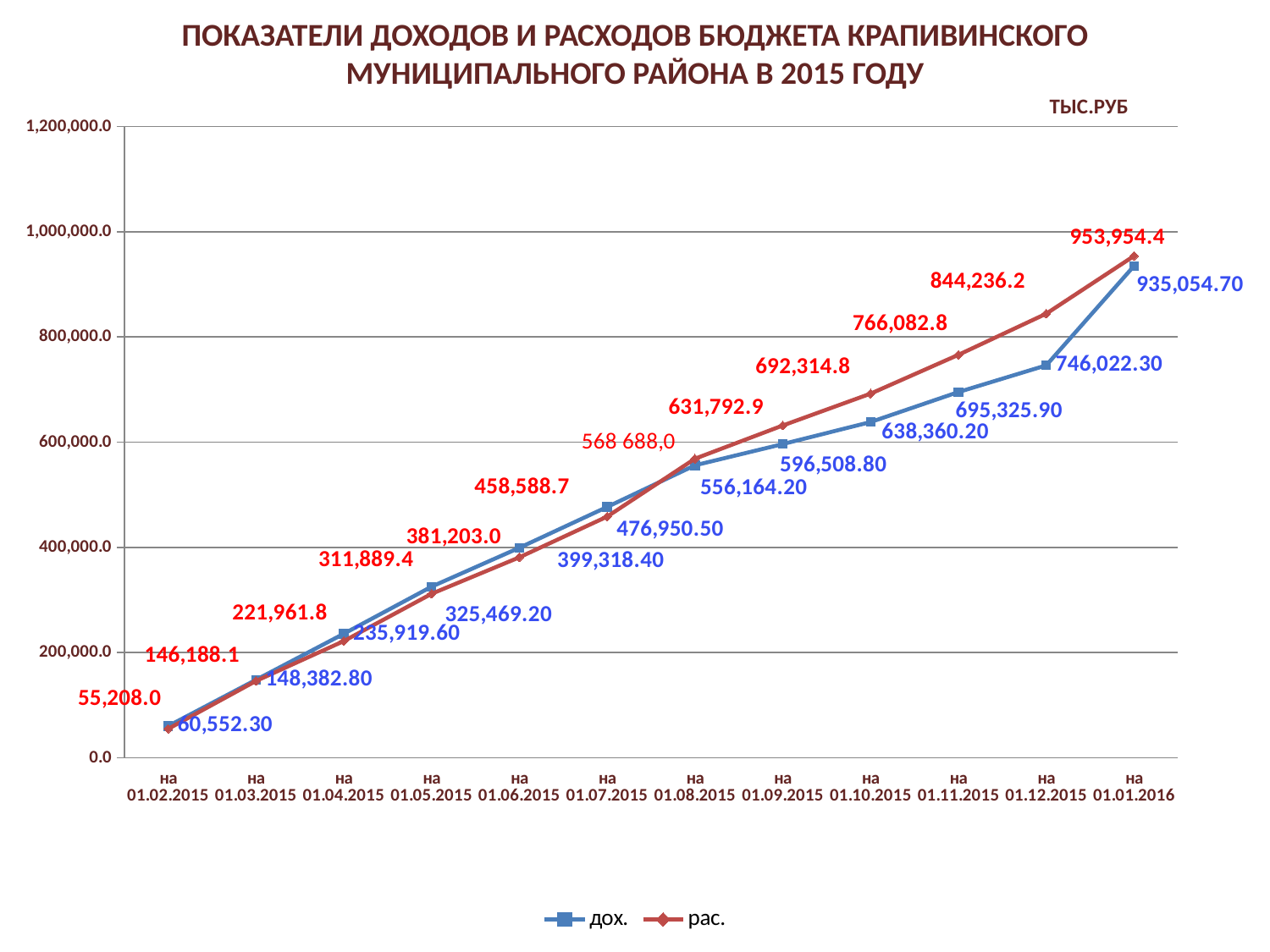
On which date does the рас. series reach its highest value? 01.01.2016 How many dates are plotted along the x axis? 12 What is the value of the рас. series on 01.11.2015? 766,082.8 What is the value of the рас. series on 01.02.2015? 55,208.0 What is the value of the дох. series on 01.01.2016? 935,054.70 Do the values of the дох. series rise or fall from 01.02.2015 to 01.01.2016? rise How many series does the legend list? 2 Which series has the larger value on 01.12.2015, дох. or рас.? рас. What is the difference between the рас. value and the дох. value on 01.01.2016? 18,899.7 What kind of chart is shown on the slide? line chart What is the value of the дох. series on 01.07.2015? 476,950.50 What is the value of the рас. series on 01.01.2016? 953,954.4